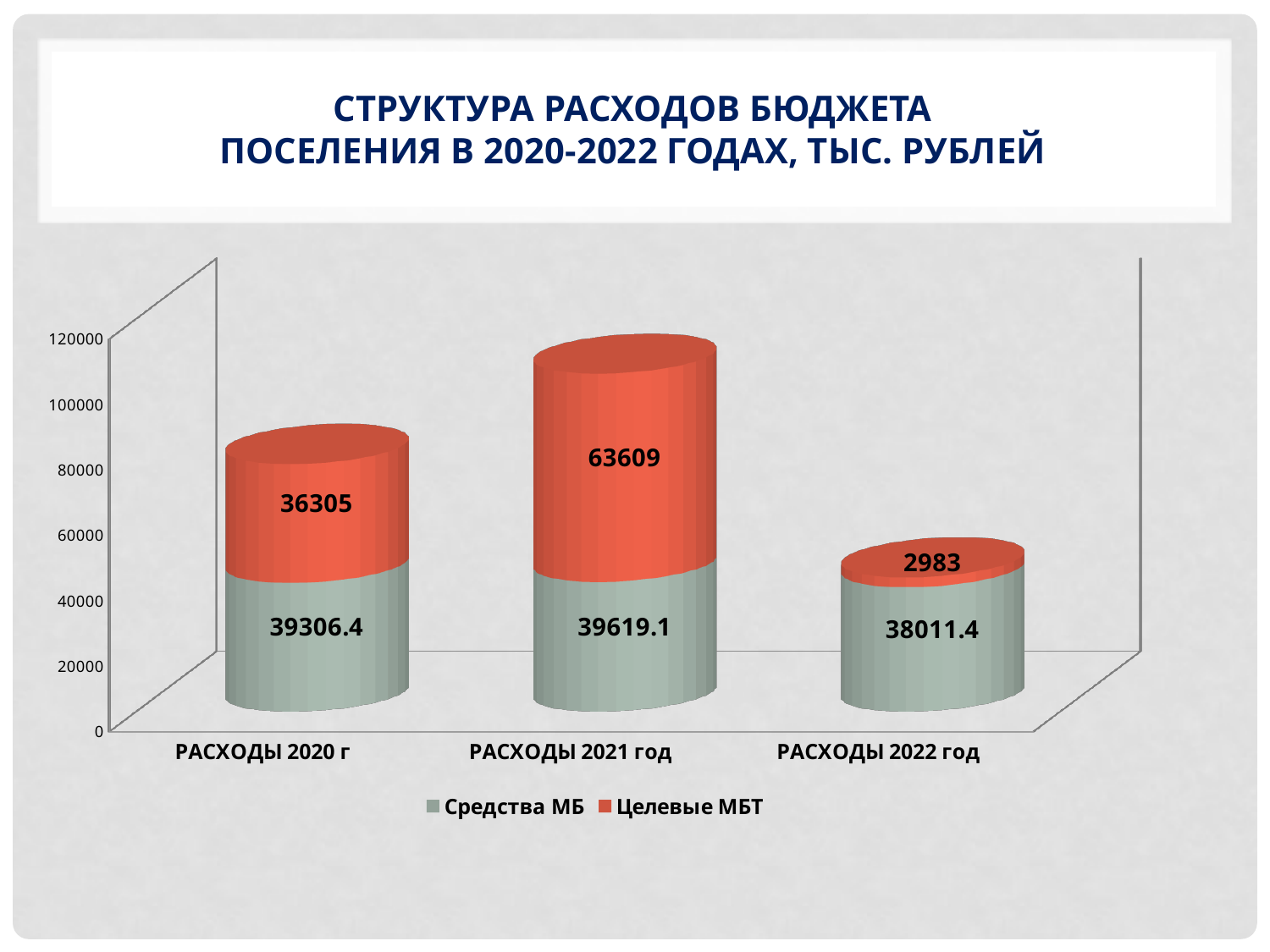
What is the total of the stacked bar for РАСХОДЫ 2021 год? 103228.1 What is the value of Целевые МБТ for РАСХОДЫ 2022 год? 2983 What is the value of Средства МБ for РАСХОДЫ 2020 г? 39306.4 What is the total of the stacked bar for РАСХОДЫ 2022 год? 40994.4 How many series does the legend list? 2 What kind of chart is shown on the slide? Stacked bar chart What is the value of Средства МБ for РАСХОДЫ 2022 год? 38011.4 Which category has the lowest value for Целевые МБТ? РАСХОДЫ 2022 год Which is larger: Средства МБ for РАСХОДЫ 2020 г or Средства МБ for РАСХОДЫ 2022 год? РАСХОДЫ 2020 г What is the value of Целевые МБТ for РАСХОДЫ 2021 год? 63609 Which category has the highest value for Целевые МБТ? РАСХОДЫ 2021 год What is the difference between the Целевые МБТ values for РАСХОДЫ 2021 год and РАСХОДЫ 2020 г? 27304